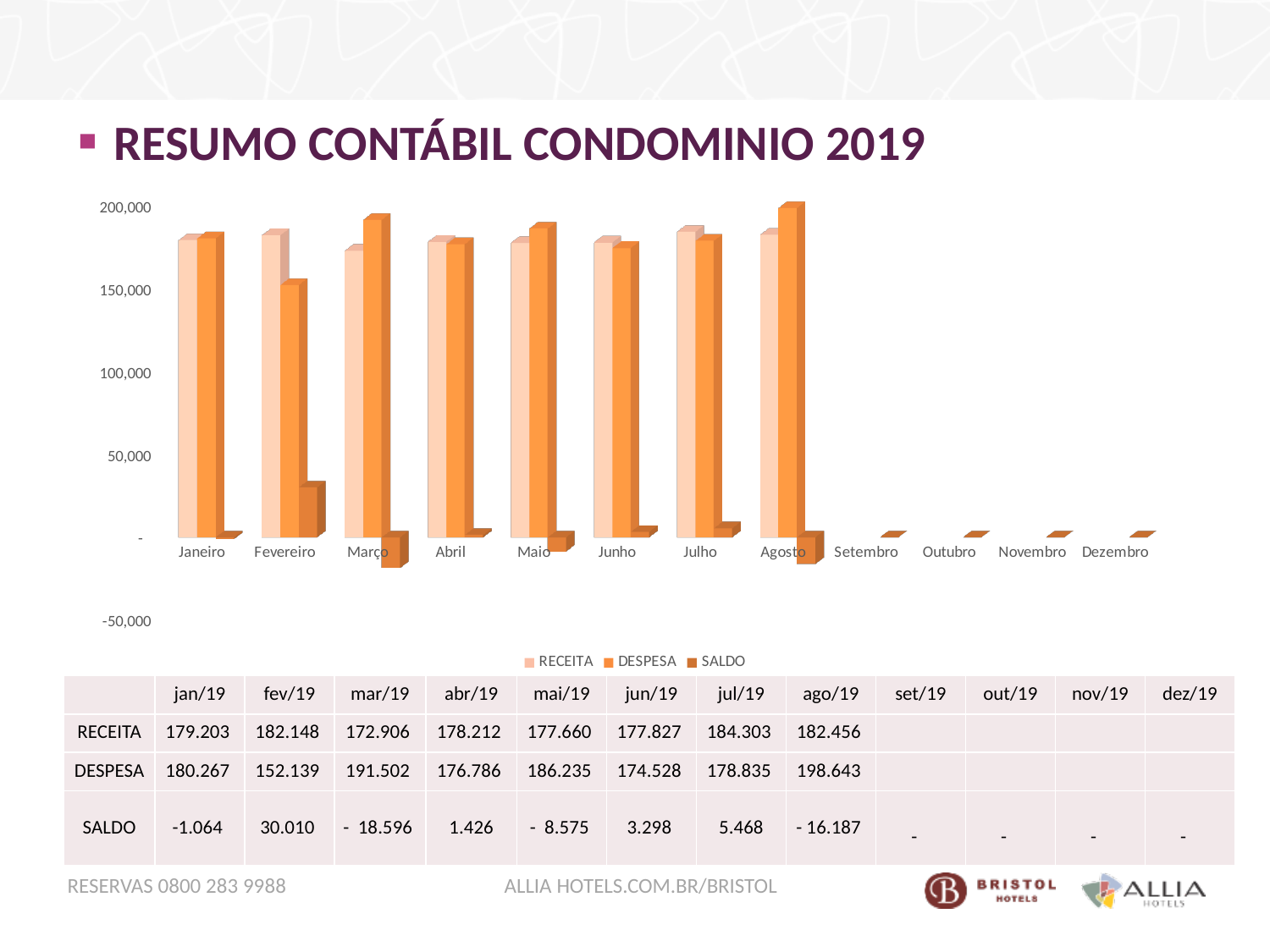
How many series does the legend list? 3 In fev/19, which is larger, RECEITA or DESPESA? RECEITA What is the DESPESA value for fev/19? 152.139 Which month has the highest DESPESA value? ago/19 Which month has the highest SALDO value? fev/19 What kind of chart is shown on the slide? Bar chart How many months are shown on the x axis of the chart? 12 Which month has the lowest RECEITA value? mar/19 Is the DESPESA value for ago/19 greater or less than 150,000? greater What is the SALDO value for mar/19? - 18.596 What is the RECEITA value for jul/19? 184.303 What is the difference between the DESPESA values for ago/19 and fev/19? 46.504